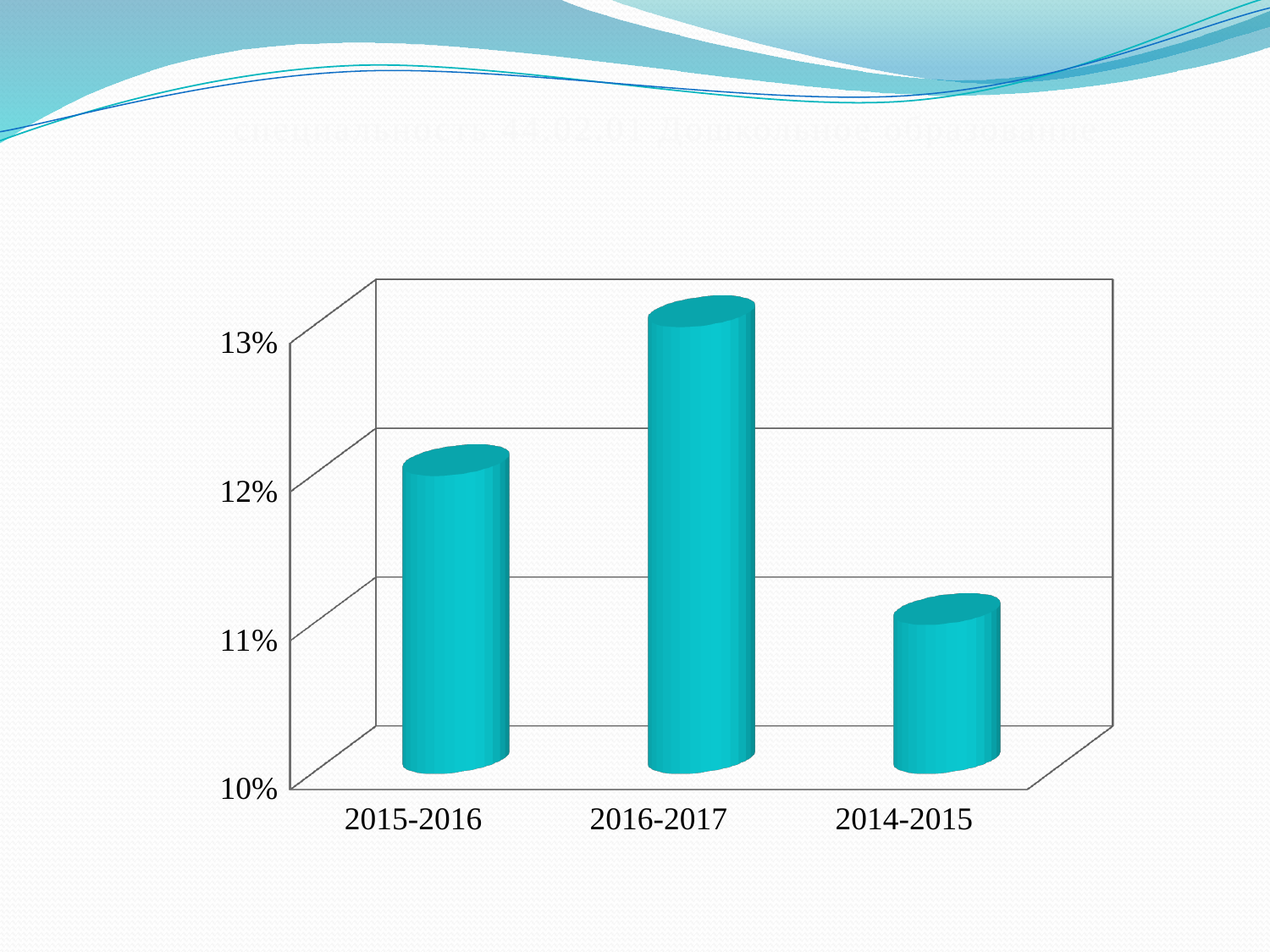
What kind of chart is shown on the slide? bar chart Is the value for 2015-2016 greater or less than 11%? greater Is the value for 2014-2015 greater or less than 12%? less What is the highest tick label shown on the vertical axis? 13% Does the value rise or fall from 2016-2017 to 2014-2015? falls Is the value for 2016-2017 greater or less than 12%? greater Which category has the highest value? 2016-2017 Which is larger, the value for 2016-2017 or the value for 2015-2016? 2016-2017 Which is larger, the value for 2015-2016 or the value for 2014-2015? 2015-2016 Does the value rise or fall from 2015-2016 to 2016-2017? rises How many categories are plotted on the x axis? 3 Which category has the lowest value? 2014-2015